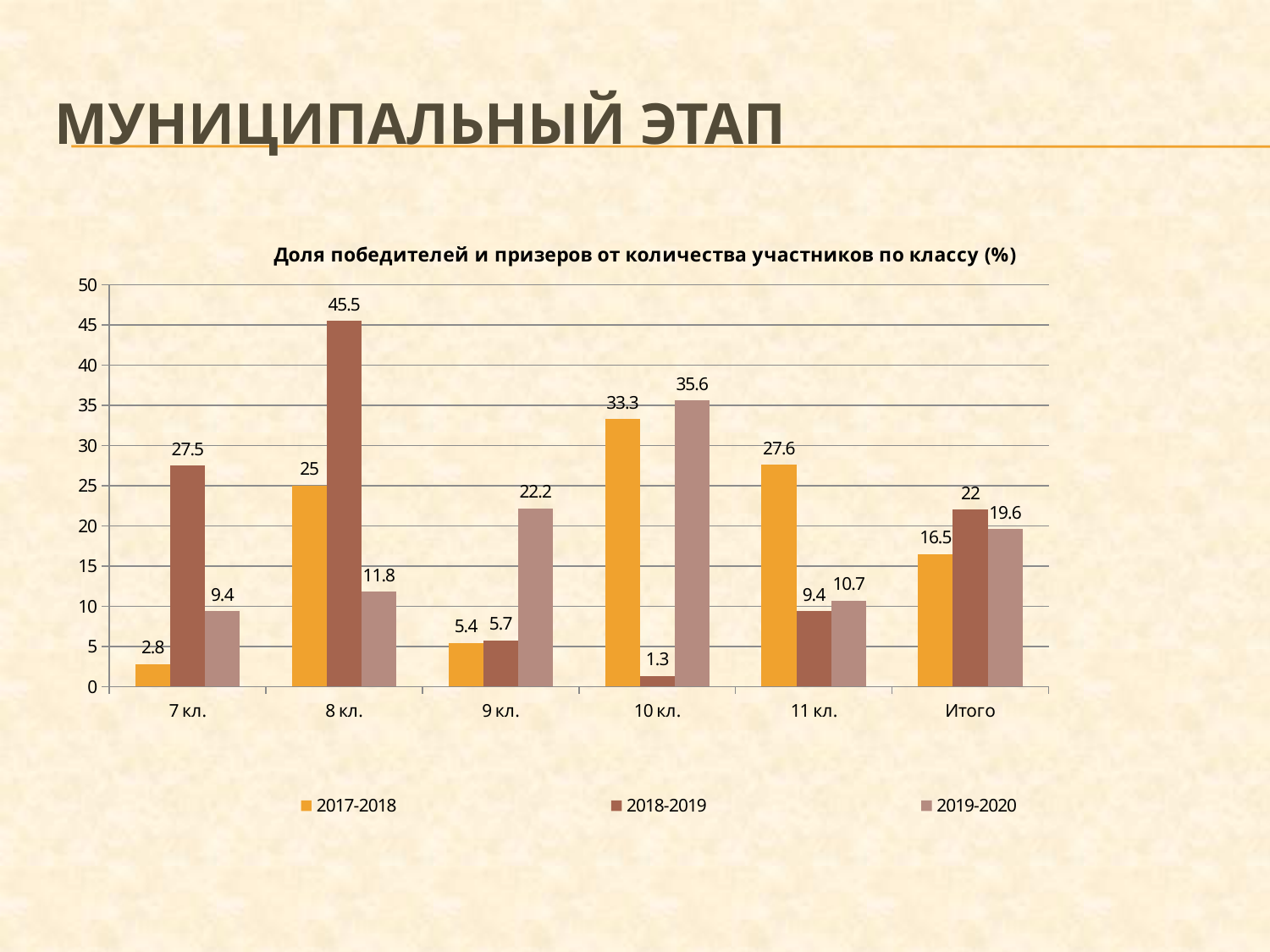
What is the value for 8 кл. in the 2018-2019 series? 45.5 What is the value for 10 кл. in the 2019-2020 series? 35.6 What is the title of the chart? Доля победителей и призеров от количества участников по классу (%) How many series does the legend list? 3 Which class has the lowest value in the 2018-2019 series? 10 кл. Which is larger for 9 кл.: the 2019-2020 value or the 2017-2018 value? 2019-2020 What is the difference between the 2018-2019 and 2017-2018 values for 7 кл.? 24.7 What kind of chart is shown on the slide? bar chart How many categories are shown on the x axis? 6 Which class has the highest value in the 2017-2018 series? 10 кл. What is the difference between the 2019-2020 and 2018-2019 values for 11 кл.? 1.3 What is the value for Итого in the 2017-2018 series? 16.5